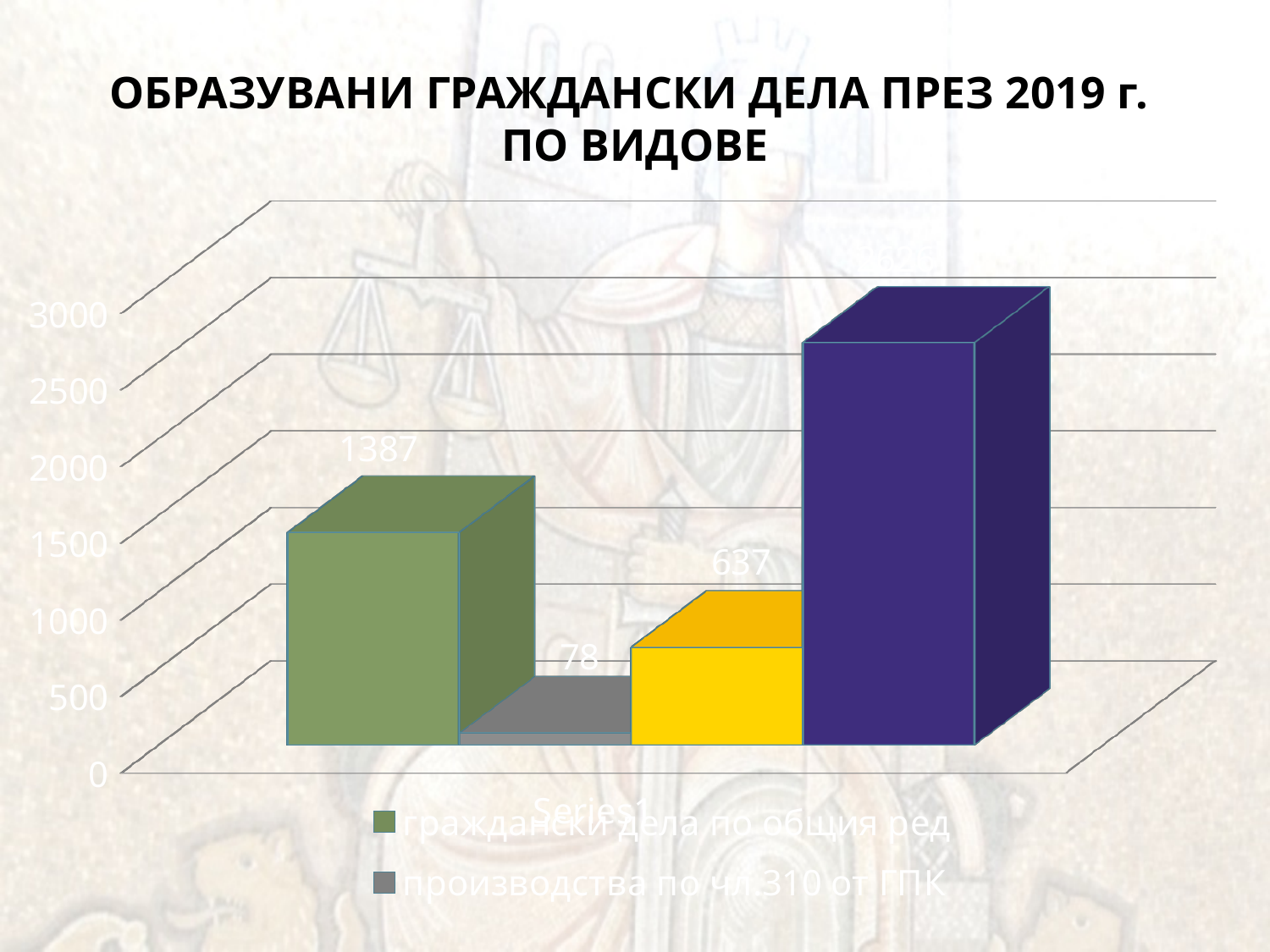
What is the difference between the green bar (1387) and the yellow bar (637)? 750 What is the title of the chart? ОБРАЗУВАНИ ГРАЖДАНСКИ ДЕЛА ПРЕЗ 2019 г. ПО ВИДОВЕ Is the value of the dark purple bar greater or less than 2000? greater How many bars are plotted in the chart? 4 Which bar is the tallest in the chart? The dark purple bar What is the difference between граждански дела по общия ред and производства по чл.310 от ГПК? 1309 Which category has the lowest value? производства по чл.310 от ГПК What type of chart is shown on the slide? Bar chart What is the value for граждански дела по общия ред? 1387 What value is labelled on the yellow bar? 637 Which is larger: граждански дела по общия ред or the yellow bar's value? граждански дела по общия ред What is the value for производства по чл.310 от ГПК? 78